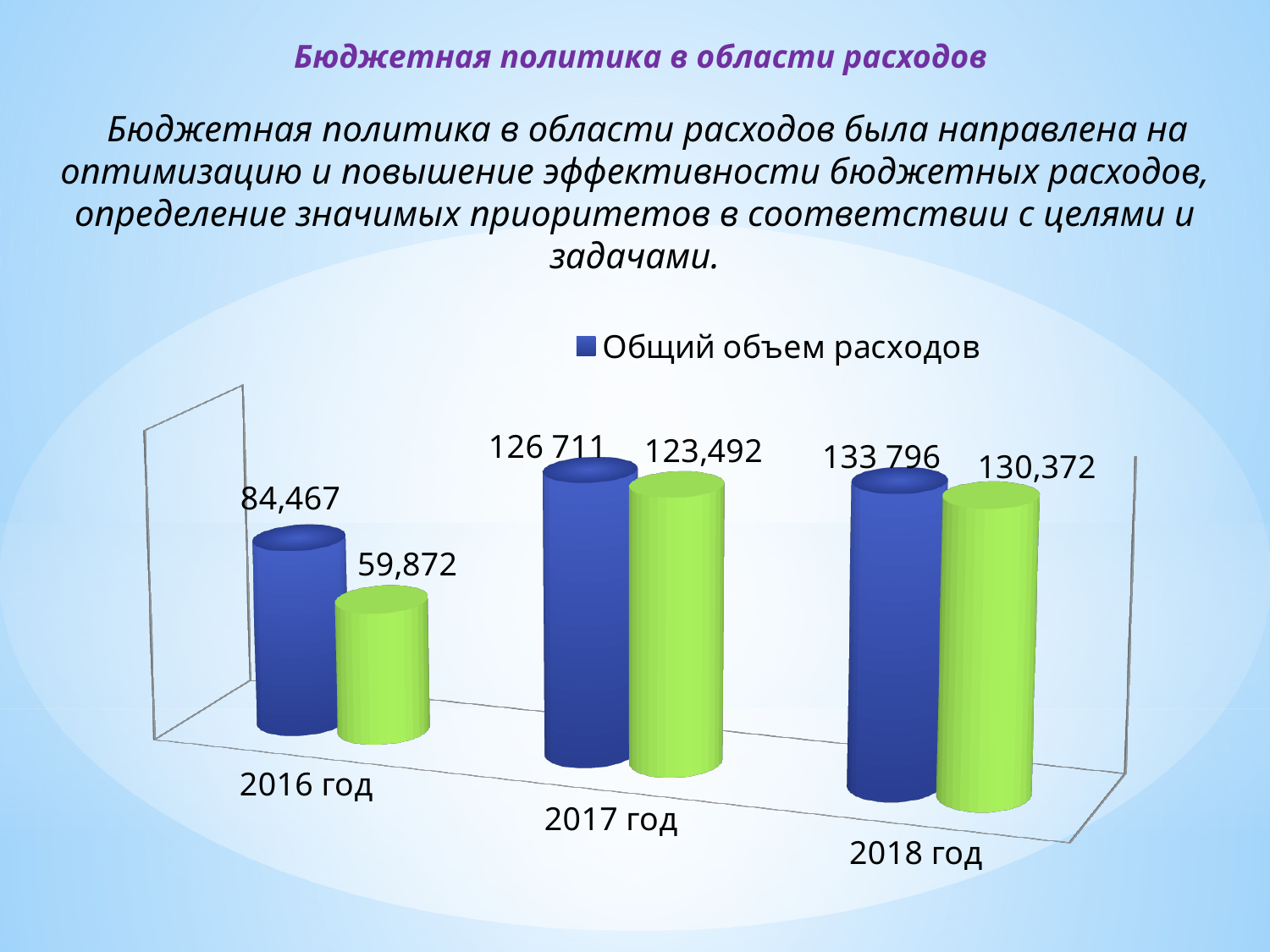
For 2016 год, which is larger: Общий объем расходов or the green series? Общий объем расходов What is the difference between the green series values for 2018 год and 2017 год? 6,880 Do the values of the green series rise or fall from 2016 год to 2018 год? rise What is the value of the green series for 2017 год? 123,492 In which year is Общий объем расходов lowest? 2016 год What is the value of the green series for 2016 год? 59,872 What is the value of the green series for 2018 год? 130,372 How many years are shown on the x axis? 3 For 2016 год, what is the difference between Общий объем расходов and the green series? 24,595 How many series does the legend list? 1 In which year is the green series highest? 2018 год What is the value of Общий объем расходов for 2016 год? 84,467